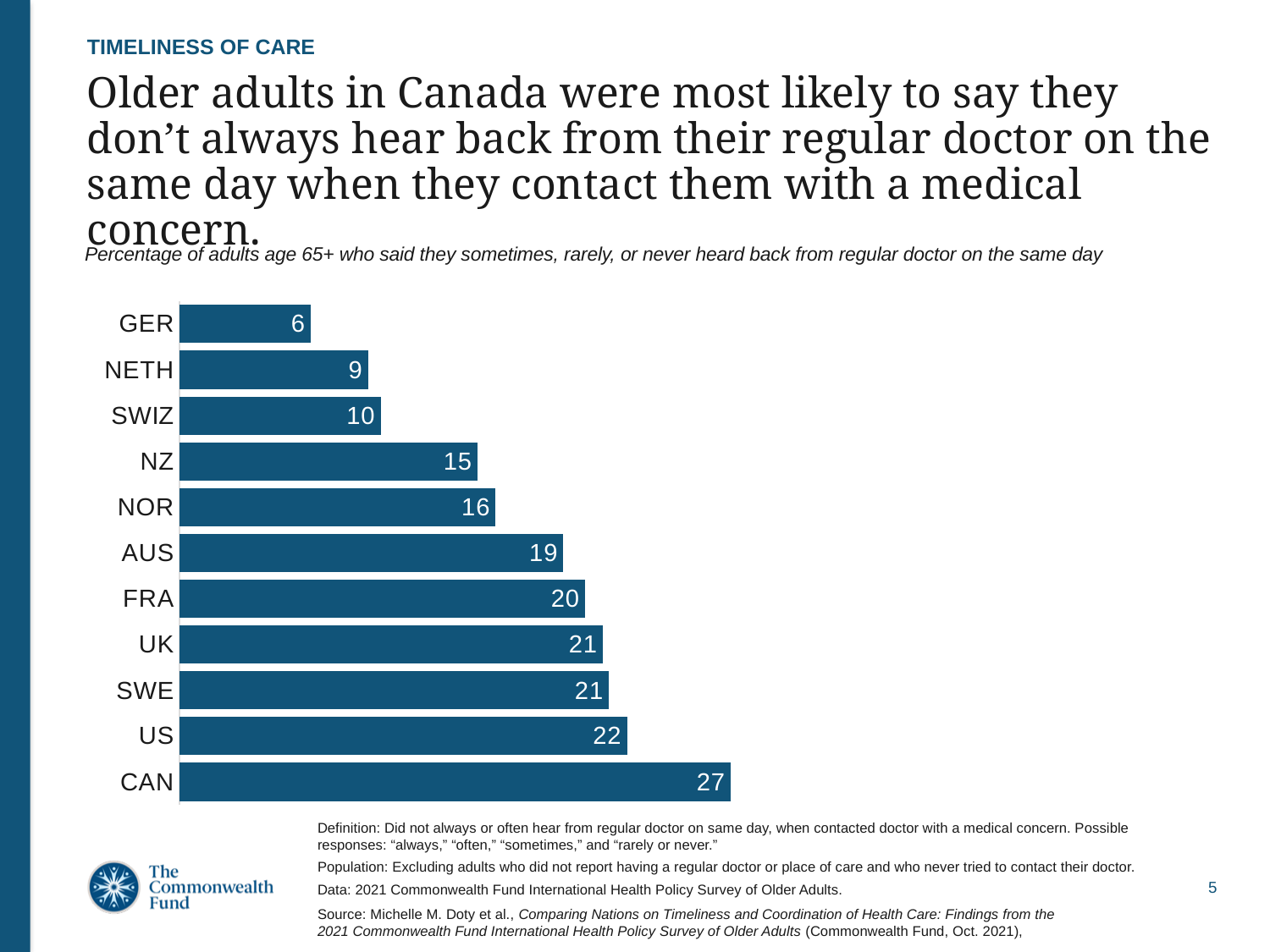
What is the difference between the values for CAN and US? 5 Do the values increase or decrease going from the top bar (GER) to the bottom bar (CAN)? Increase What is the value for NOR? 16 What is the value for US? 22 What is the value for GER? 6 Which is larger, the value for AUS or the value for NZ? AUS Which country has the lowest value? GER What kind of chart is shown on the slide? Bar chart Which country has the highest value? CAN What is the difference between the values for SWIZ and GER? 4 What is the value for CAN? 27 How many countries are shown in the chart? 11